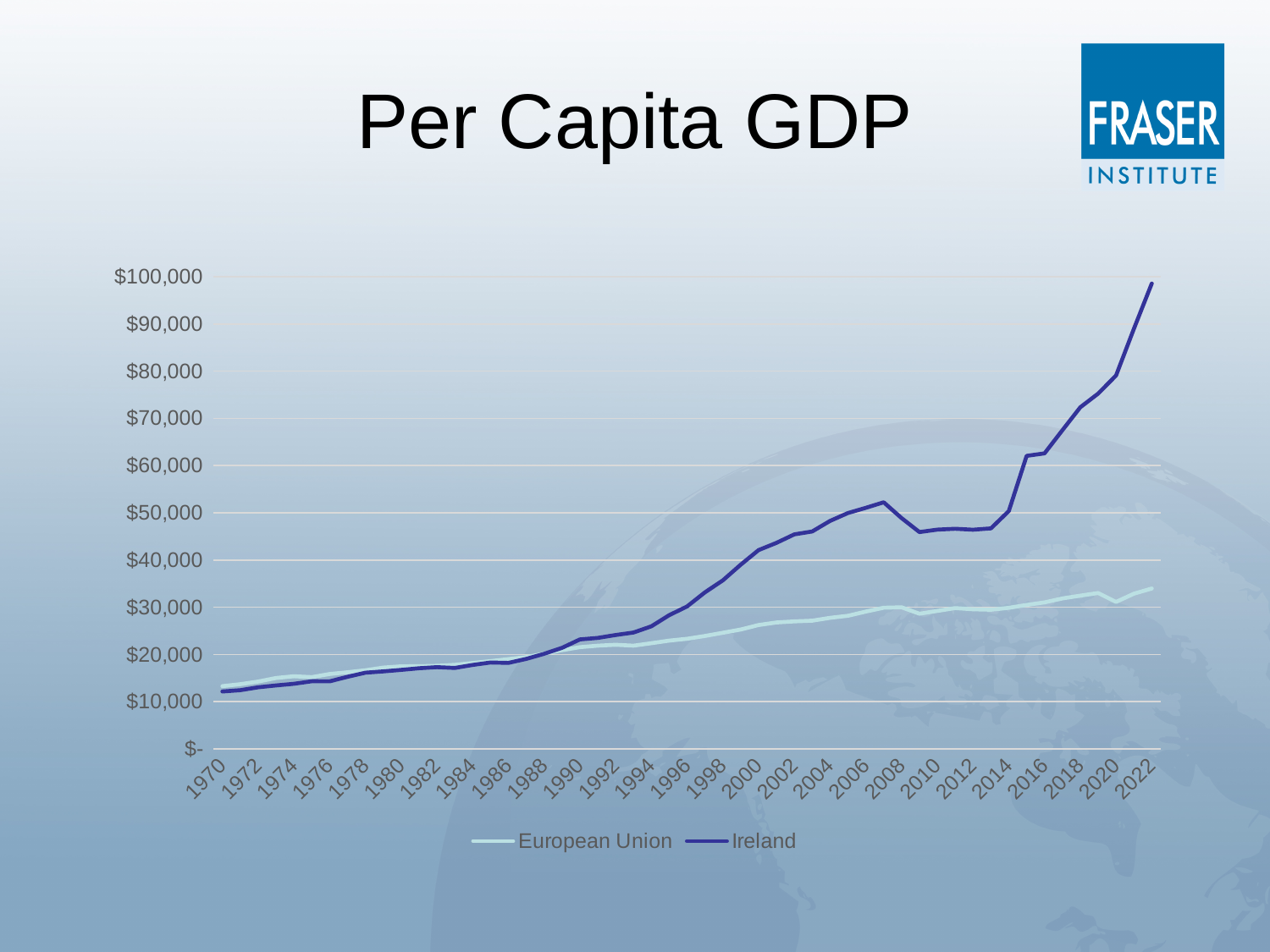
How many series does the legend list? 2 Which two series are listed in the legend? European Union and Ireland Is the value for Ireland in 2010 greater or less than $50,000? less Is the value for the European Union in 1970 greater or less than $20,000? less Is the value for Ireland in 2016 greater or less than $60,000? greater Which series has the larger value in 2022, European Union or Ireland? Ireland What is the title of the chart? Per Capita GDP In which year does the Ireland series reach its highest value? 2022 What kind of chart is shown on the slide? line chart Does the Ireland series overall rise or fall from 1970 to 2022? rise